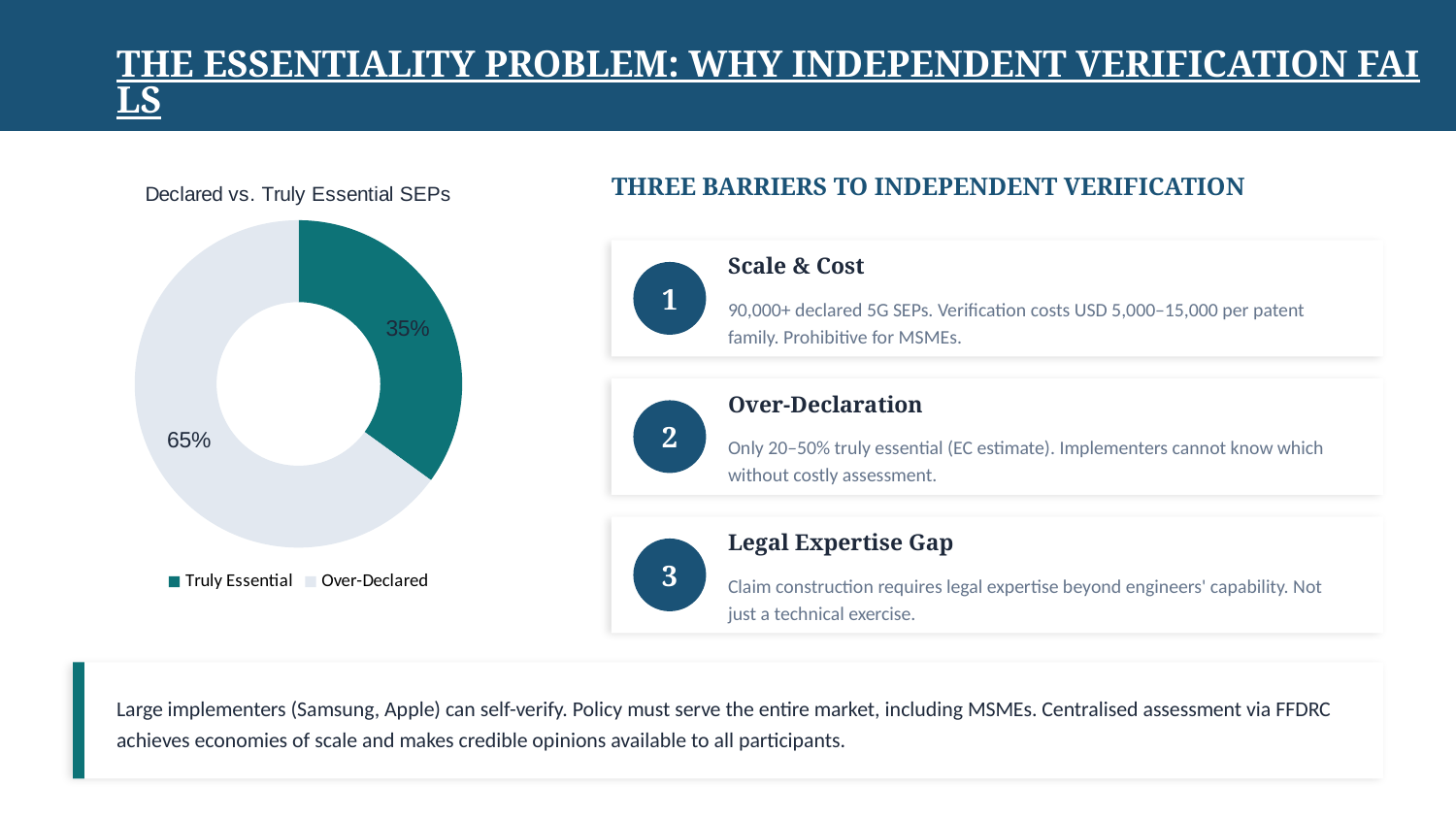
What share of the pie is labelled Truly Essential? 35% What colour is the Truly Essential slice in the chart? Teal Which is larger, the Truly Essential slice or the Over-Declared slice? Over-Declared What is the title of the chart on the slide? Declared vs. Truly Essential SEPs What is the difference in percentage points between the Over-Declared and Truly Essential slices? 30% How many slices does the pie chart have? 2 Which slice is the smallest in the chart? Truly Essential What share of the pie is labelled Over-Declared? 65% What kind of chart is shown on the slide? Pie chart (doughnut) Which slice is the largest in the chart? Over-Declared How many entries does the chart legend list? 2 What is the total of the two slices shown in the chart? 100%